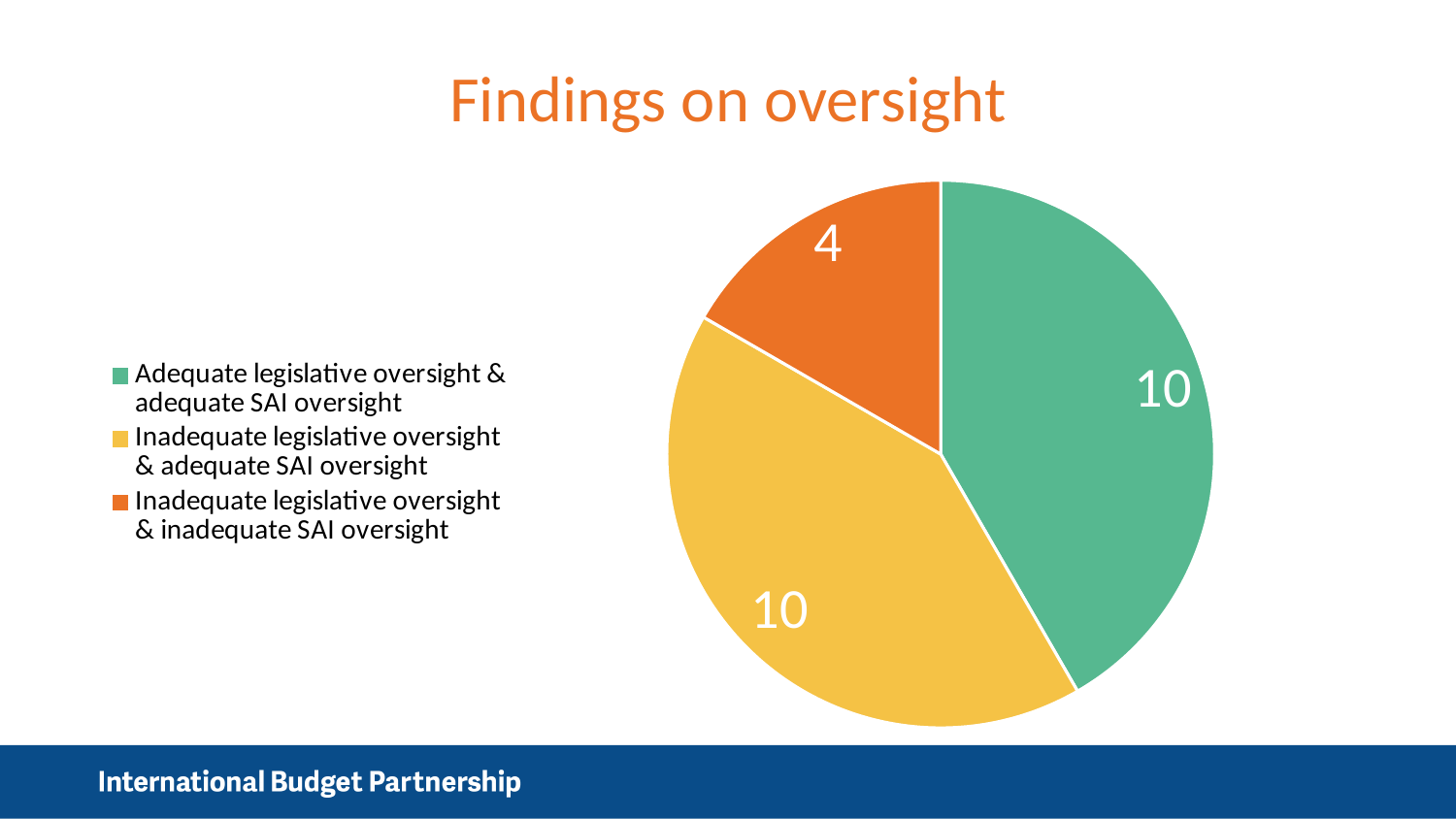
What is the value of the 'Adequate legislative oversight & adequate SAI oversight' slice? 10 How many slices does the pie chart have? 3 What is the total of all the slices in the pie chart? 24 What colour is the 'Inadequate legislative oversight & inadequate SAI oversight' slice? Orange What is the difference between the 'Adequate legislative oversight & adequate SAI oversight' slice and the 'Inadequate legislative oversight & inadequate SAI oversight' slice? 6 What type of chart is shown on the slide? Pie chart What is the value of the 'Inadequate legislative oversight & adequate SAI oversight' slice? 10 How many entries does the legend list? 3 What is the title of the slide? Findings on oversight Which is larger: the 'Inadequate legislative oversight & adequate SAI oversight' slice or the 'Inadequate legislative oversight & inadequate SAI oversight' slice? Inadequate legislative oversight & adequate SAI oversight What is the value of the 'Inadequate legislative oversight & inadequate SAI oversight' slice? 4 Which category has the smallest slice of the pie? Inadequate legislative oversight & inadequate SAI oversight